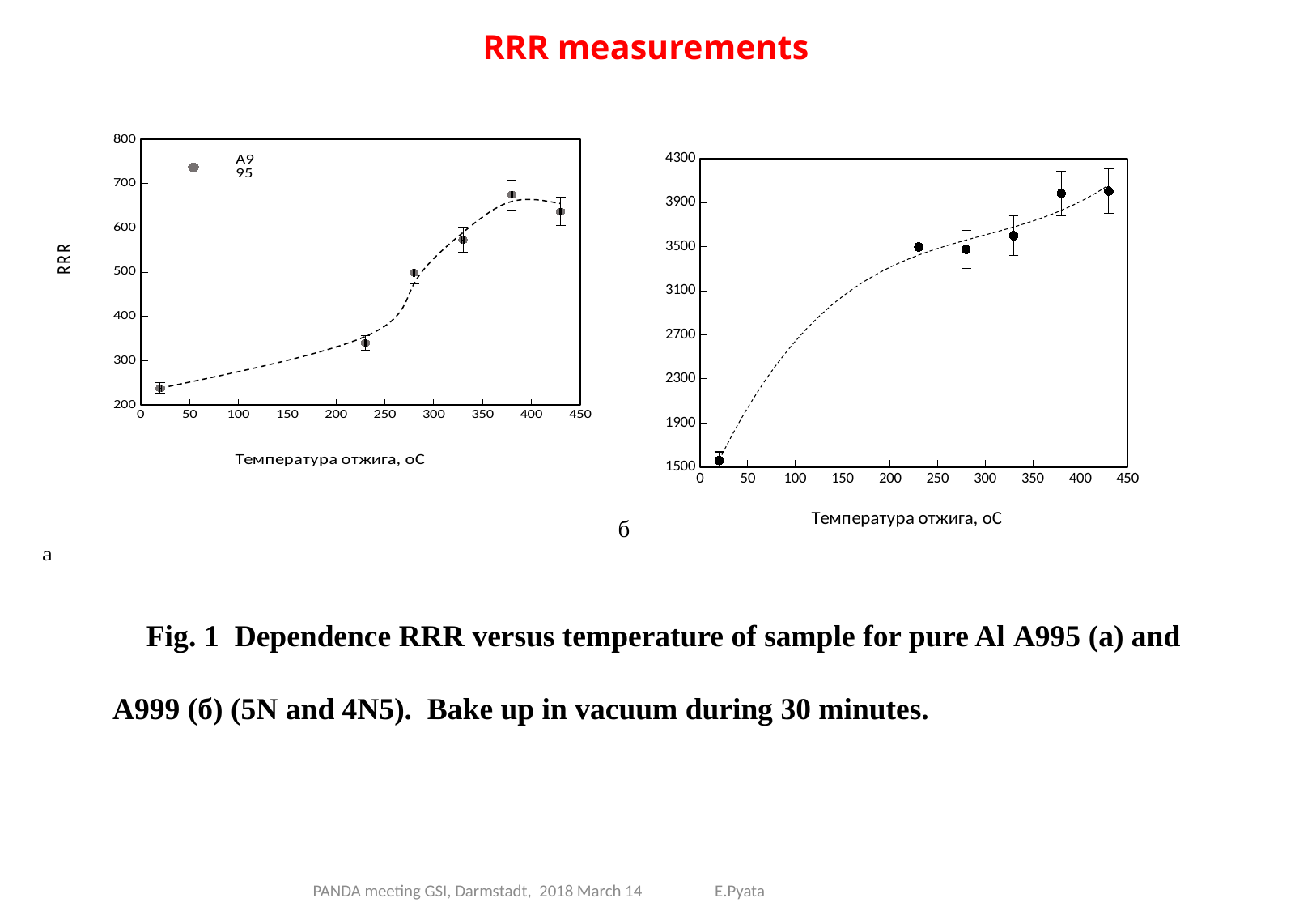
What kind of chart is the left chart (a)? scatter chart On the left chart (a), is the RRR value at an annealing temperature of 20 greater or less than 300? less On the left chart (a), at which annealing temperature is the RRR value lowest? 20 On the left chart (a), which has the larger RRR value: the point at 230 or the point at 330? 330 On the right chart (б), at which annealing temperature is the RRR value lowest? 20 On the right chart (б), is the RRR value at an annealing temperature of 20 greater or less than 1900? less On the right chart (б), is the RRR value at an annealing temperature of 380 greater or less than 3500? greater What is the y-axis label of the left chart (a)? RRR On the right chart (б), do the RRR values generally rise or fall as annealing temperature increases? rise How many data points are plotted on the right chart (б)? 6 How many data points are plotted on the left chart (a)? 6